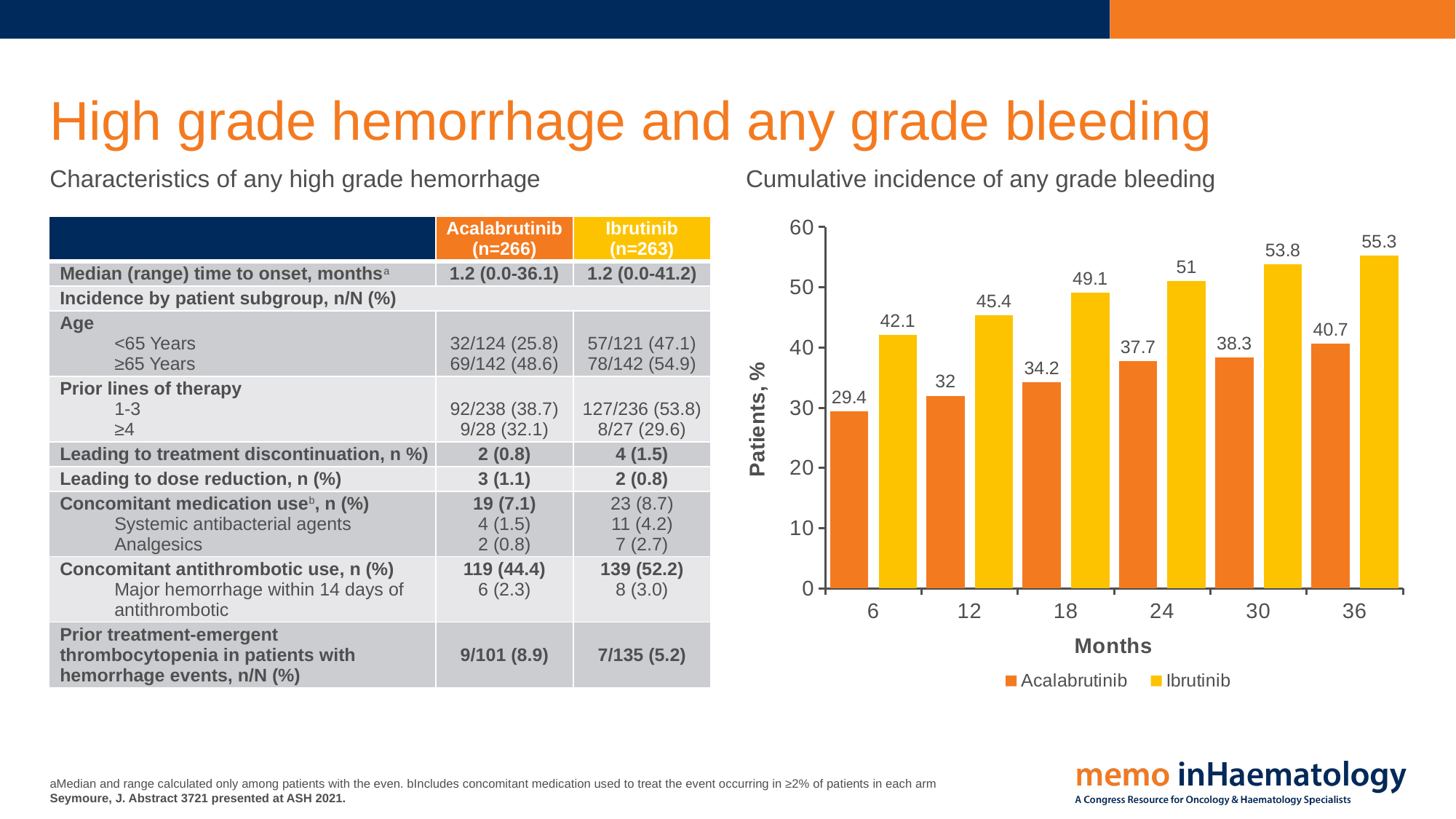
In the cumulative incidence of any grade bleeding chart, what is the difference between Ibrutinib and Acalabrutinib at 36 months? 14.6 In the cumulative incidence of any grade bleeding chart, which series has the larger value at 24 months, Acalabrutinib or Ibrutinib? Ibrutinib In the cumulative incidence of any grade bleeding chart, what is the value for Ibrutinib at 18 months? 49.1 What kind of chart is the cumulative incidence of any grade bleeding chart? Bar chart In the cumulative incidence of any grade bleeding chart, at which month is the Acalabrutinib value highest? 36 In the cumulative incidence of any grade bleeding chart, what is the value for Acalabrutinib at 6 months? 29.4 How many series does the legend of the cumulative incidence of any grade bleeding chart list? 2 In the cumulative incidence of any grade bleeding chart, is the value for Acalabrutinib at 12 months greater or less than 40? less In the cumulative incidence of any grade bleeding chart, do the Acalabrutinib values rise or fall from 6 to 36 months? Rise How many month categories are shown on the x axis of the cumulative incidence of any grade bleeding chart? 6 In the cumulative incidence of any grade bleeding chart, what is the value for Ibrutinib at 36 months? 55.3 In the cumulative incidence of any grade bleeding chart, at which month is the Ibrutinib value lowest? 6